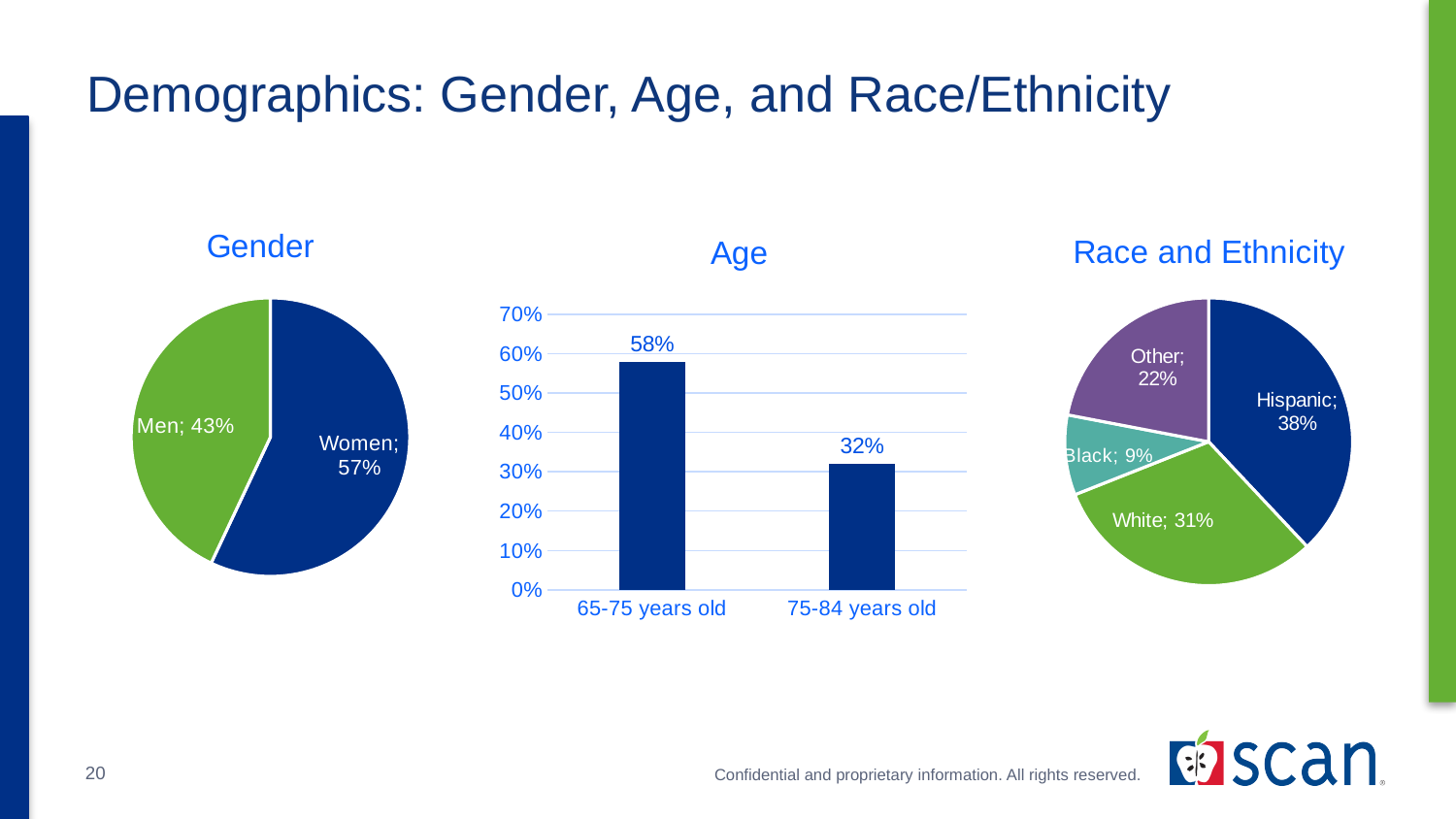
In the Race and Ethnicity chart, which group has the largest share? Hispanic In the Race and Ethnicity chart, what is the share for White? 31% In the Gender chart, what percentage are Men? 43% In the Race and Ethnicity chart, which group has the smallest share? Black In the Age chart, what is the difference between the 65-75 years old and 75-84 years old values? 26% In the Age chart, what is the value for 75-84 years old? 32% In the Race and Ethnicity chart, how many slices are there? 4 In the Gender chart, what percentage are Women? 57% What kind of chart is the Age chart? Bar chart In the Age chart, what is the value for 65-75 years old? 58% What kind of chart is the Gender chart? Pie chart How many categories does the Age chart show? 2